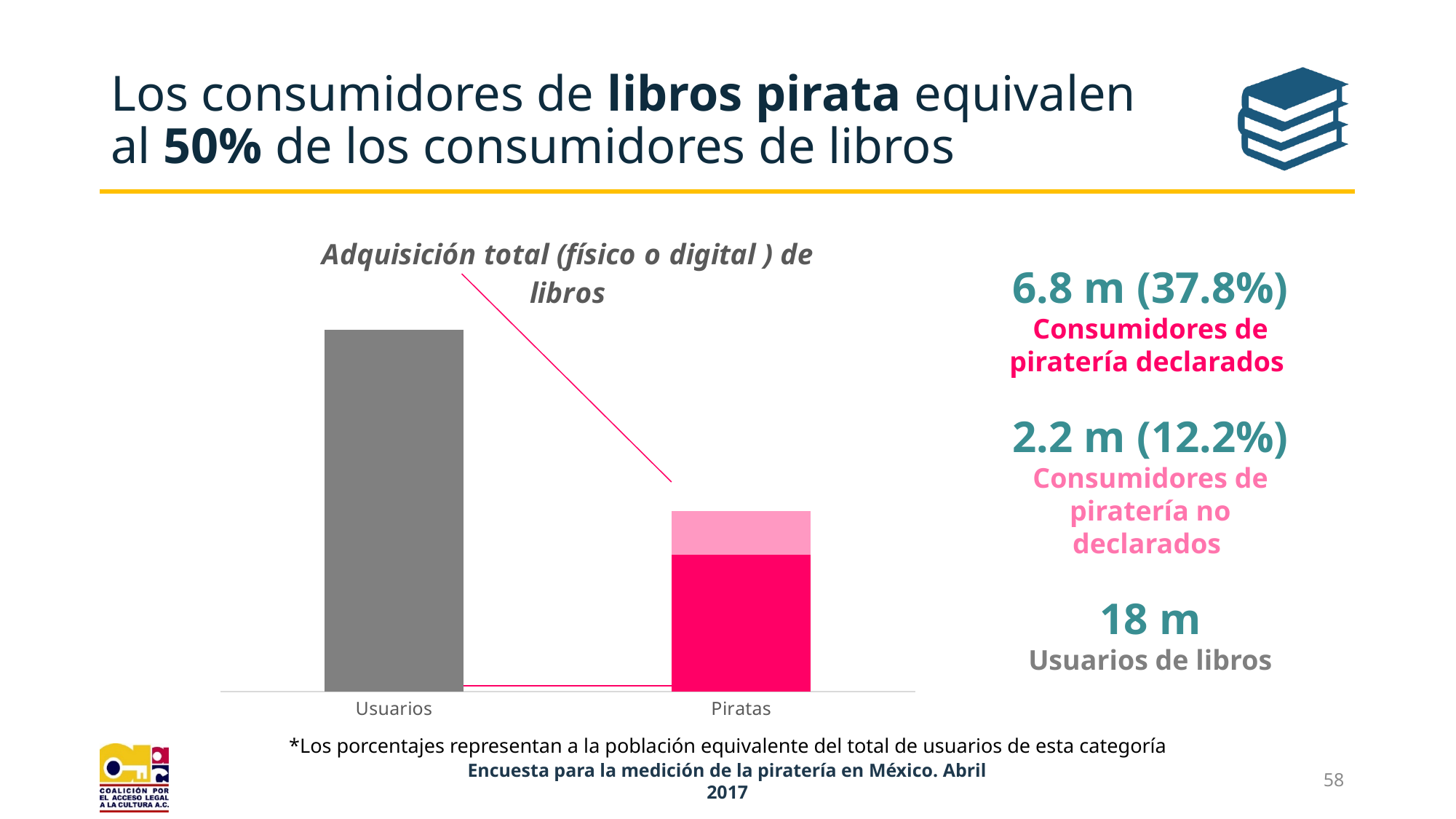
What is the difference between declared piracy consumers (6.8 m) and non-declared piracy consumers (2.2 m)? 4.6 m What percentage of book users do the non-declared piracy consumers represent, according to the slide? 12.2% According to the slide, how many book users (Usuarios de libros) are there? 18 m What kind of chart is shown on the slide? bar chart Which category has the lowest bar in the chart? Piratas Adding the declared (37.8%) and non-declared (12.2%) piracy consumer percentages, what share of book users does the Piratas bar represent in total? 50% Which category's bar is split into two stacked segments? Piratas What is the title of the chart? Adquisición total (físico o digital ) de libros Which category has the taller bar, Usuarios or Piratas? Usuarios What colour is the Usuarios bar in the chart? gray According to the slide, how many declared piracy consumers (Consumidores de piratería declarados) are there? 6.8 m How many categories are shown on the x axis of the chart? 2